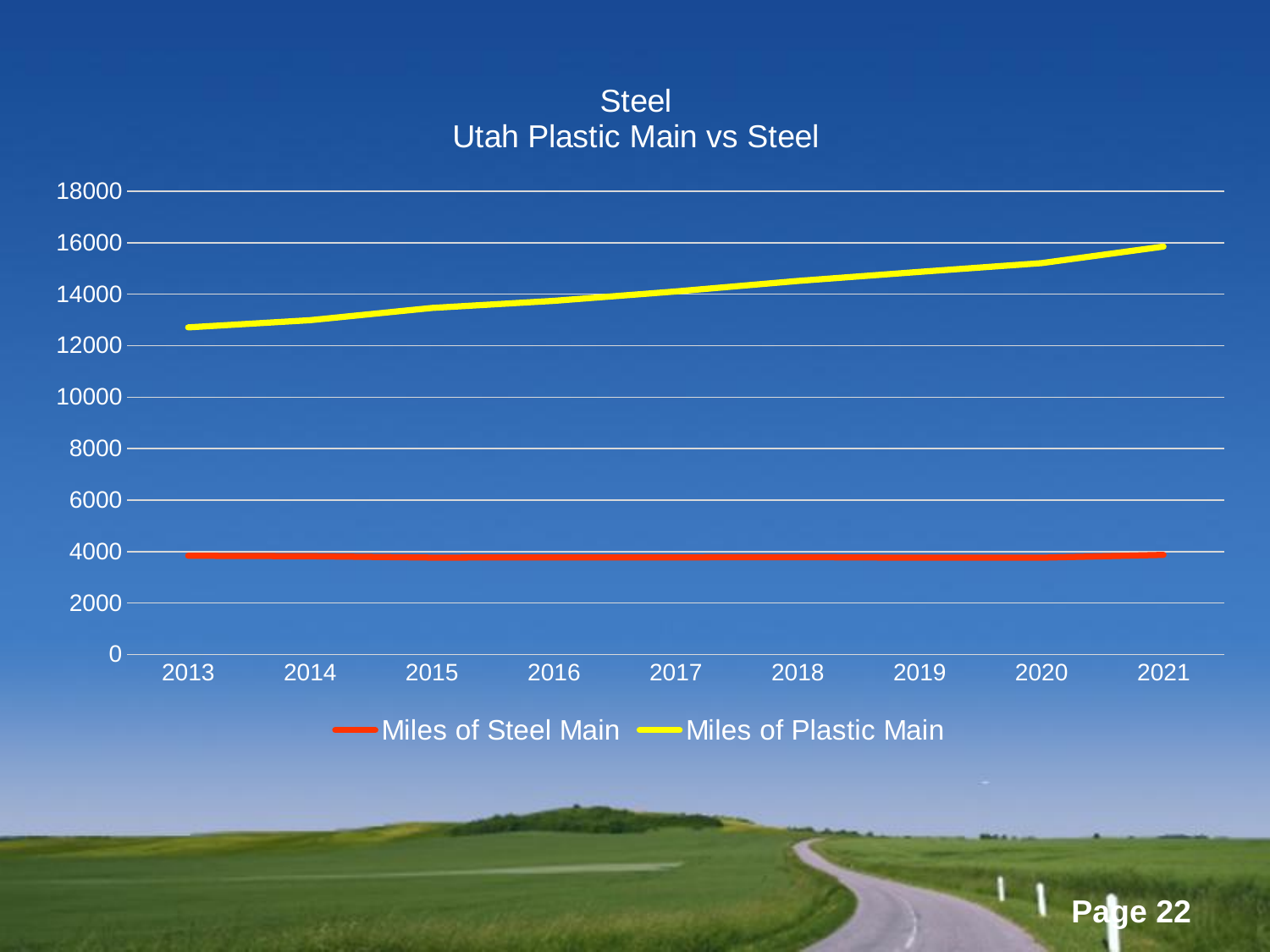
In 2021, which series has the larger value, Miles of Steel Main or Miles of Plastic Main? Miles of Plastic Main In which year is Miles of Plastic Main highest? 2021 Is the value for Miles of Plastic Main in 2013 greater or less than 12000? greater Which colour is used for the Miles of Plastic Main line? yellow How many series does the legend list? 2 Is the value for Miles of Plastic Main in 2021 greater or less than 14000? greater How many years are shown along the x axis? 9 In which year is Miles of Plastic Main lowest? 2013 What kind of chart is shown on the slide? line chart Does the Miles of Plastic Main line rise or fall from 2013 to 2021? rise Is the value for Miles of Steel Main in 2017 greater or less than 6000? less What is the title of the chart? Steel Utah Plastic Main vs Steel